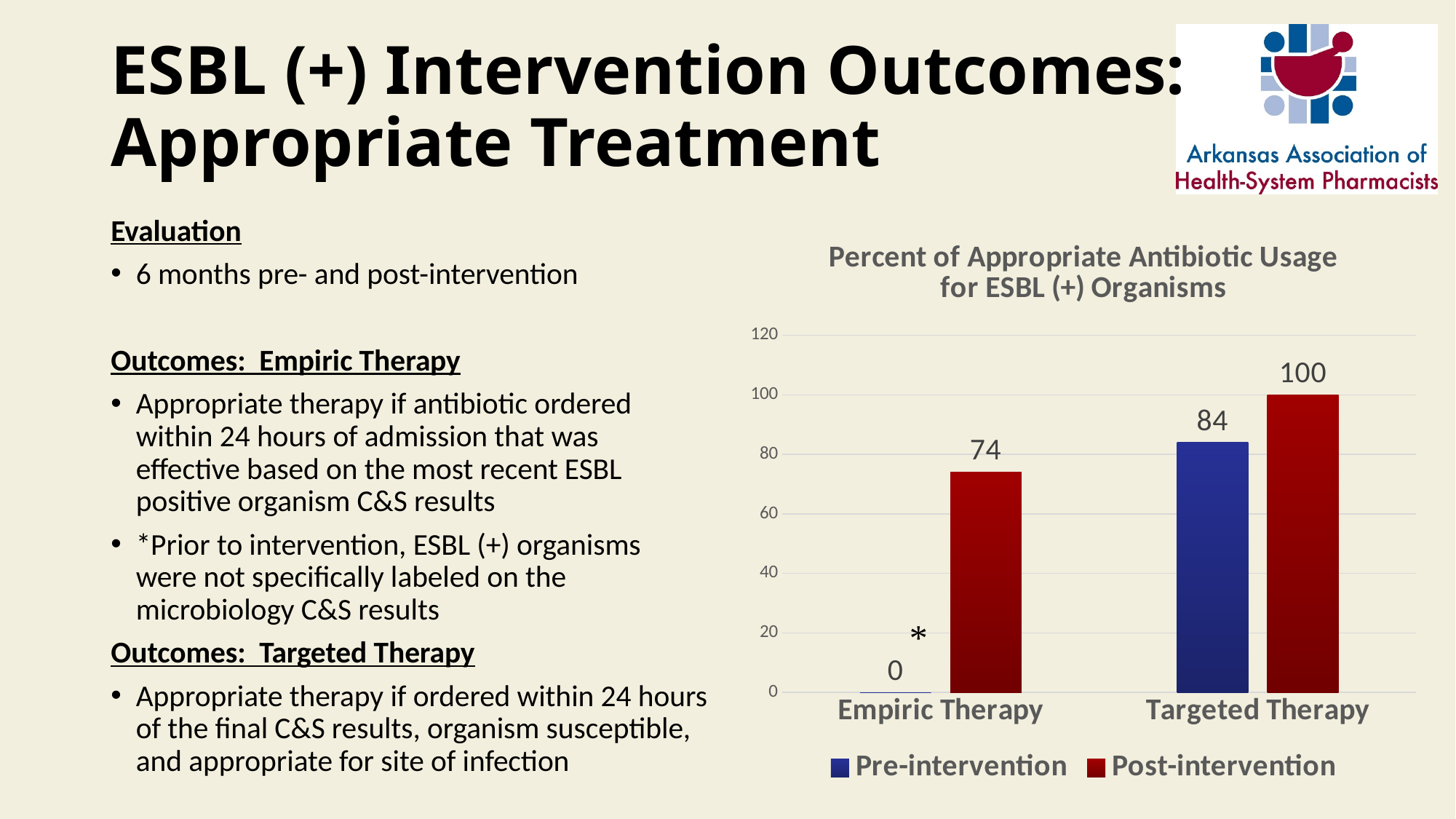
How many categories are shown on the x axis? 2 What is the difference between the Post-intervention values for Targeted Therapy and Empiric Therapy? 26 How many series does the legend list? 2 What is the Post-intervention value for Targeted Therapy? 100 What kind of chart is shown on the slide? Bar chart Which is larger: the Pre-intervention value for Targeted Therapy or the Post-intervention value for Empiric Therapy? Pre-intervention value for Targeted Therapy What is the difference between the Post-intervention and Pre-intervention values for Targeted Therapy? 16 What is the title of the chart? Percent of Appropriate Antibiotic Usage for ESBL (+) Organisms What is the Post-intervention value for Empiric Therapy? 74 What is the Pre-intervention value for Targeted Therapy? 84 Which category has the highest Post-intervention value? Targeted Therapy What is the Pre-intervention value for Empiric Therapy? 0